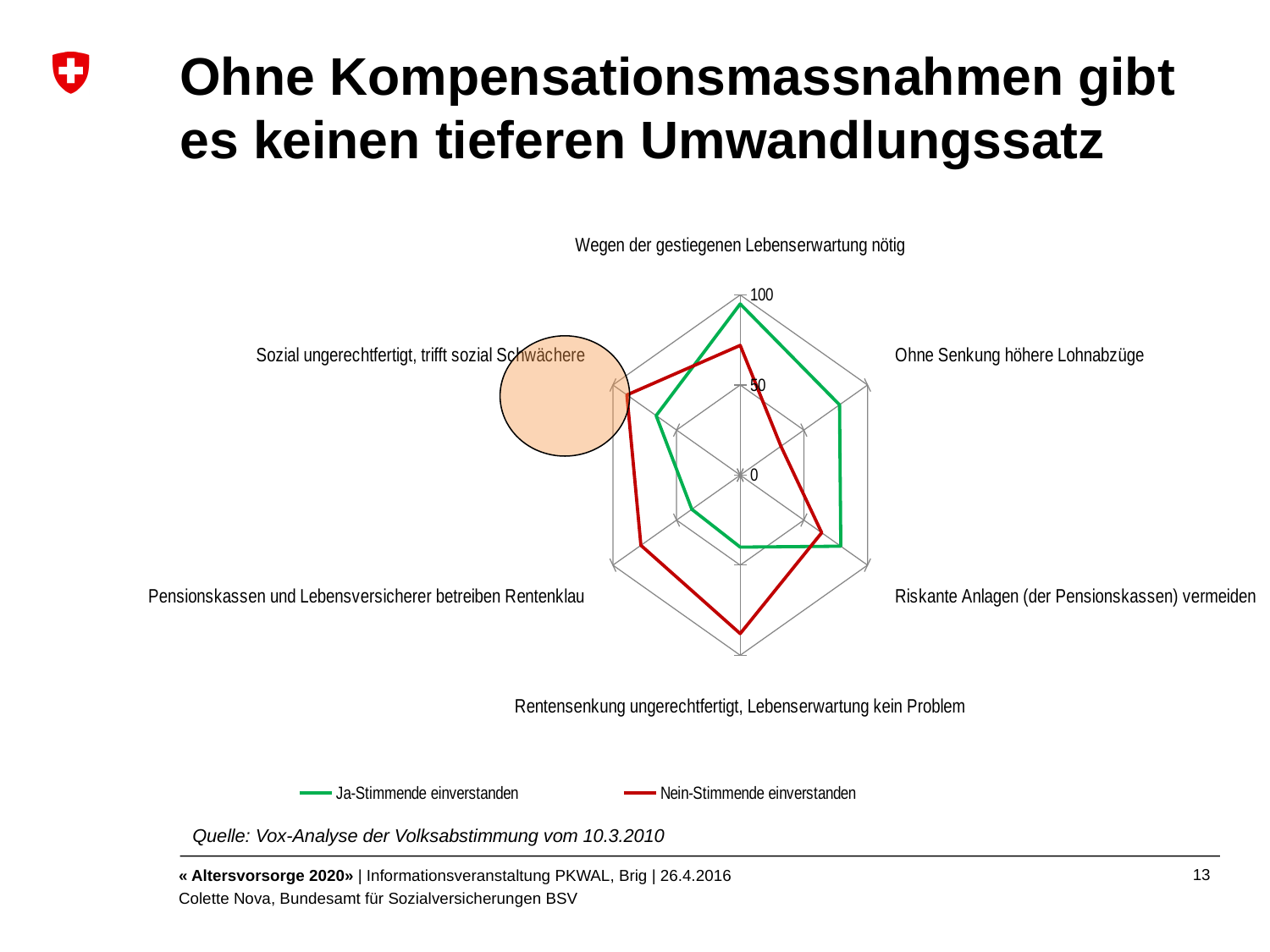
How many series does the legend list? 2 Is the value for 'Ja-Stimmende einverstanden' on 'Wegen der gestiegenen Lebenserwartung nötig' greater or less than 50? greater Is the value for 'Nein-Stimmende einverstanden' on 'Rentensenkung ungerechtfertigt, Lebenserwartung kein Problem' greater or less than 50? greater Is the value for 'Nein-Stimmende einverstanden' on 'Sozial ungerechtfertigt, trifft sozial Schwächere' greater or less than 50? greater What kind of chart is shown on the slide? Radar chart How many categories (axes) does the radar chart have? 6 For 'Ohne Senkung höhere Lohnabzüge', which series has the larger value, Ja-Stimmende or Nein-Stimmende? Ja-Stimmende einverstanden For 'Pensionskassen und Lebensversicherer betreiben Rentenklau', which series has the larger value, Ja-Stimmende or Nein-Stimmende? Nein-Stimmende einverstanden What colour is the line for 'Nein-Stimmende einverstanden'? Red For 'Wegen der gestiegenen Lebenserwartung nötig', which series has the larger value, Ja-Stimmende or Nein-Stimmende? Ja-Stimmende einverstanden